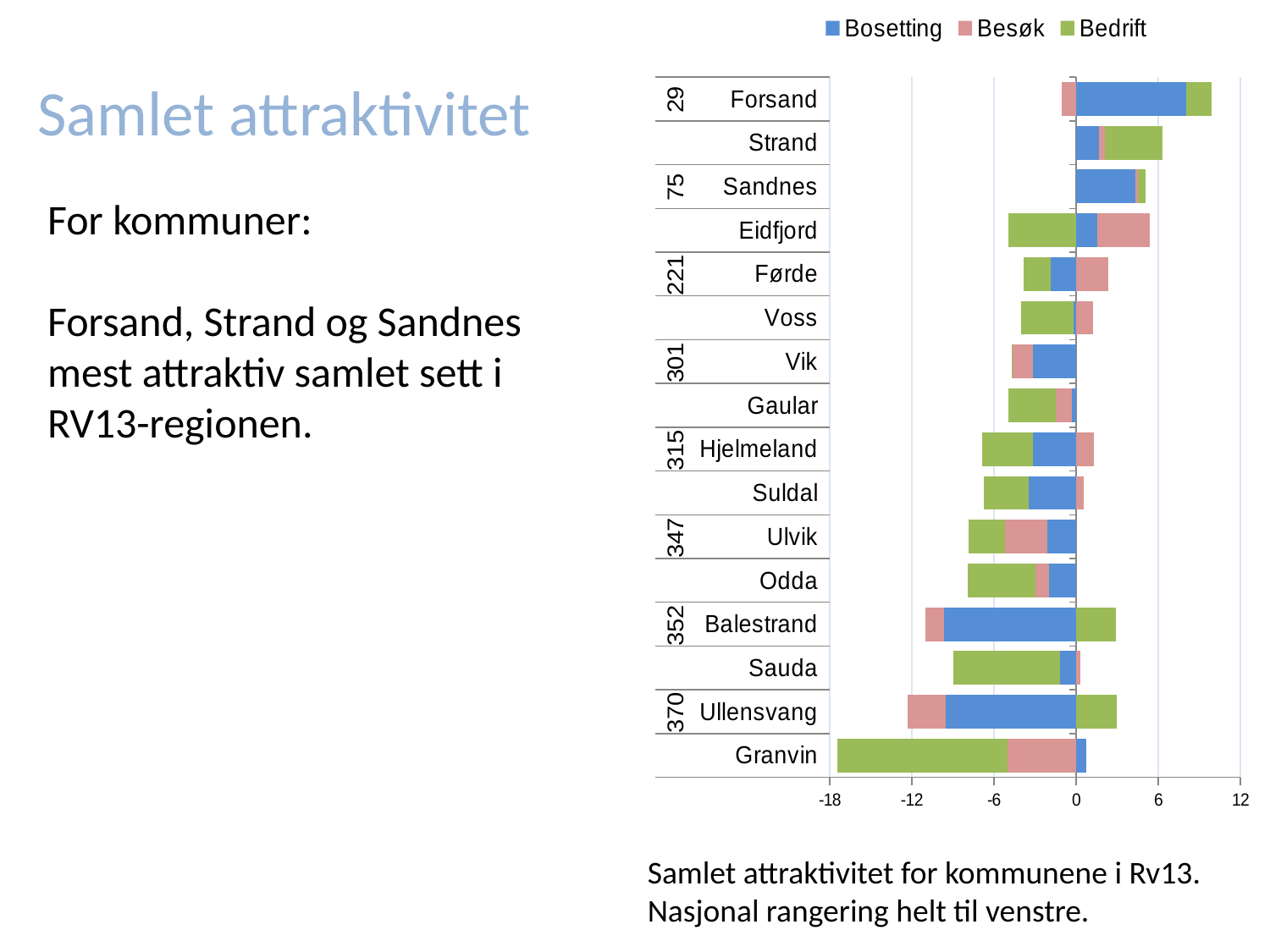
Is the Bosetting value for Sandnes greater or less than 6? less Is the Bedrift value for Granvin greater or less than -6? less Which series are listed in the chart legend? Bosetting, Besøk, Bedrift How many series does the chart legend list? 3 Is the Bosetting value for Balestrand greater or less than -6? less What kind of chart is shown on the slide? Stacked bar chart How many municipalities (categories) are plotted in the chart? 16 Which has the larger Bosetting value, Forsand or Sandnes? Forsand Which municipality has the highest Bosetting value in the chart? Forsand Which colour represents the Bedrift series in the chart? Green Which municipality has the lowest (most negative) Bedrift value in the chart? Granvin